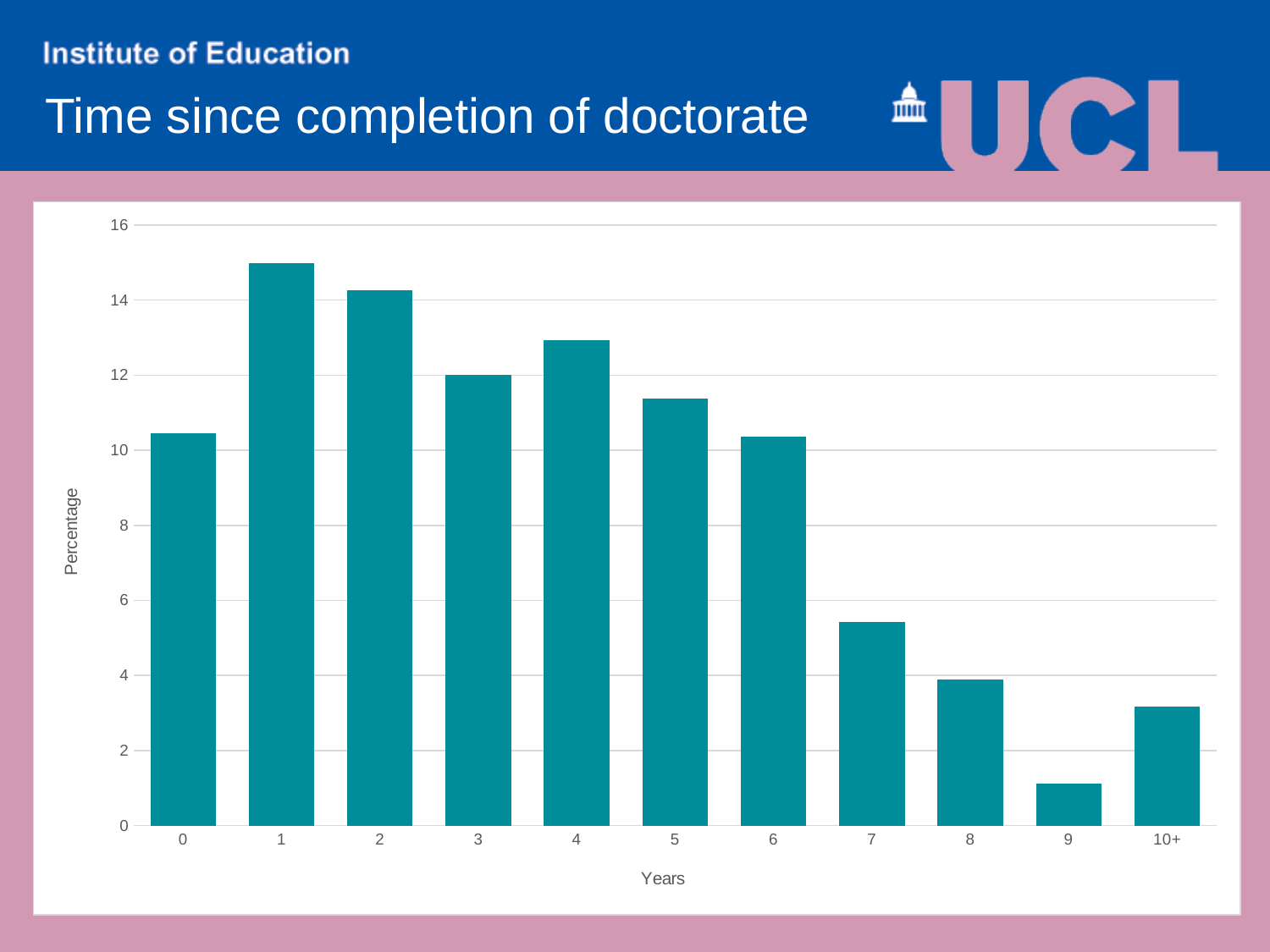
Is the value for 9 years greater or less than 2? less Which has a higher percentage, 4 years or 5 years? 4 years Is the value for 2 years greater or less than 14? greater What kind of chart is shown on the slide? bar chart Do the values generally rise or fall from 1 year to 9 years along the x axis? fall Is the value for 0 years greater or less than 10? greater Which category on the Years axis has the highest percentage? 1 Which category on the Years axis has the lowest percentage? 9 Which has a higher percentage, 8 years or 10+ years? 8 years What is the label of the vertical axis? Percentage How many categories are shown along the Years axis? 11